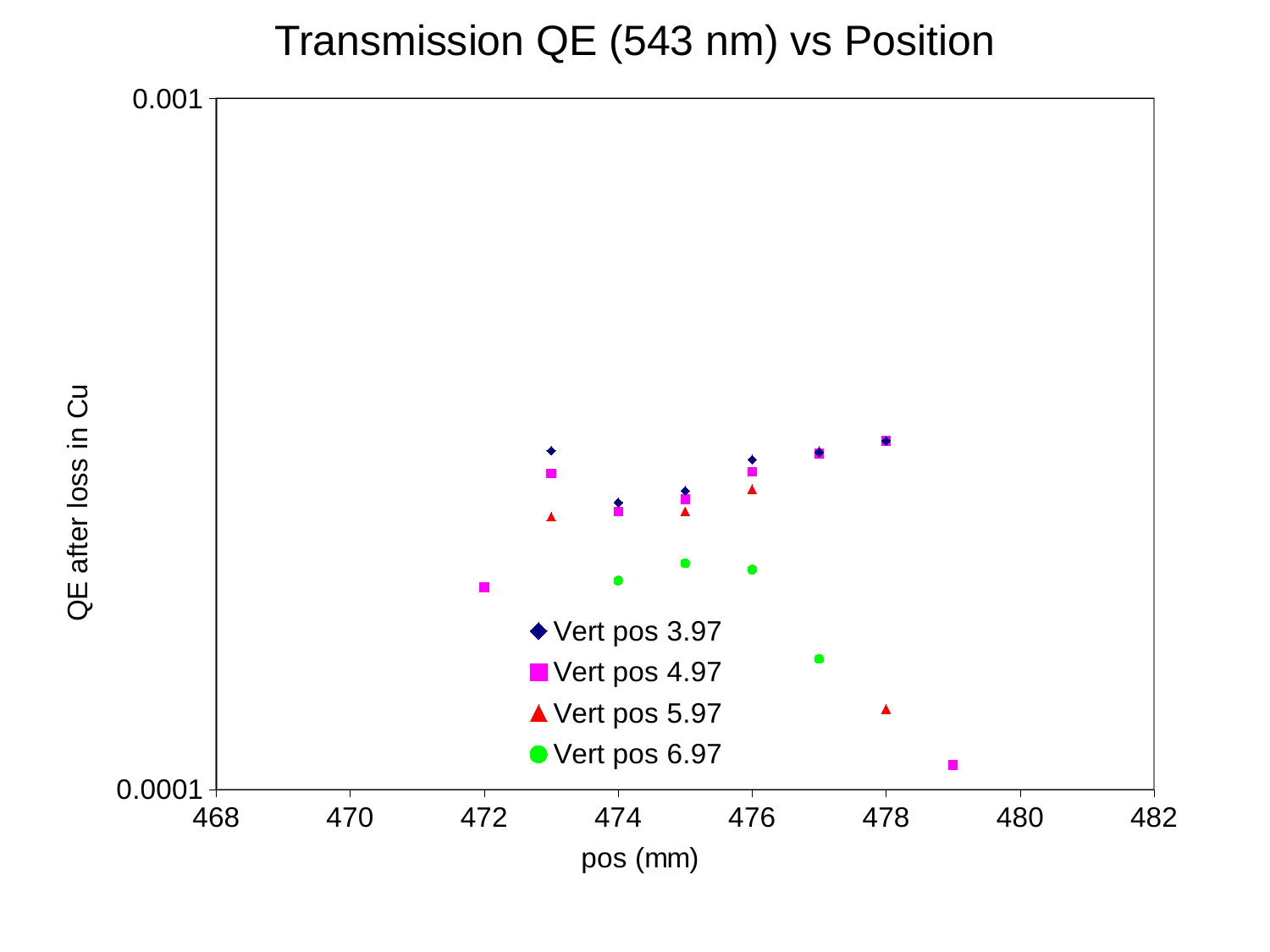
How many data points are plotted for the Vert pos 6.97 series? 4 At pos 473 mm, which series has the larger value: Vert pos 3.97 or Vert pos 5.97? Vert pos 3.97 Which series contains the lowest plotted point on the chart? Vert pos 4.97 Do the values for the Vert pos 5.97 series rise or fall from pos 476 mm to pos 478 mm? fall At pos 477 mm, which series has the larger value: Vert pos 3.97 or Vert pos 6.97? Vert pos 3.97 At which pos (mm) does the Vert pos 3.97 series reach its highest value? 478 What is the title of the chart? Transmission QE (543 nm) vs Position What is the label of the x axis? pos (mm) What kind of chart is shown on the slide? scatter chart How many series does the legend list? 4 Is the value for Vert pos 4.97 at pos 479 mm greater or less than 0.001? less How many data points are plotted for the Vert pos 4.97 series? 8